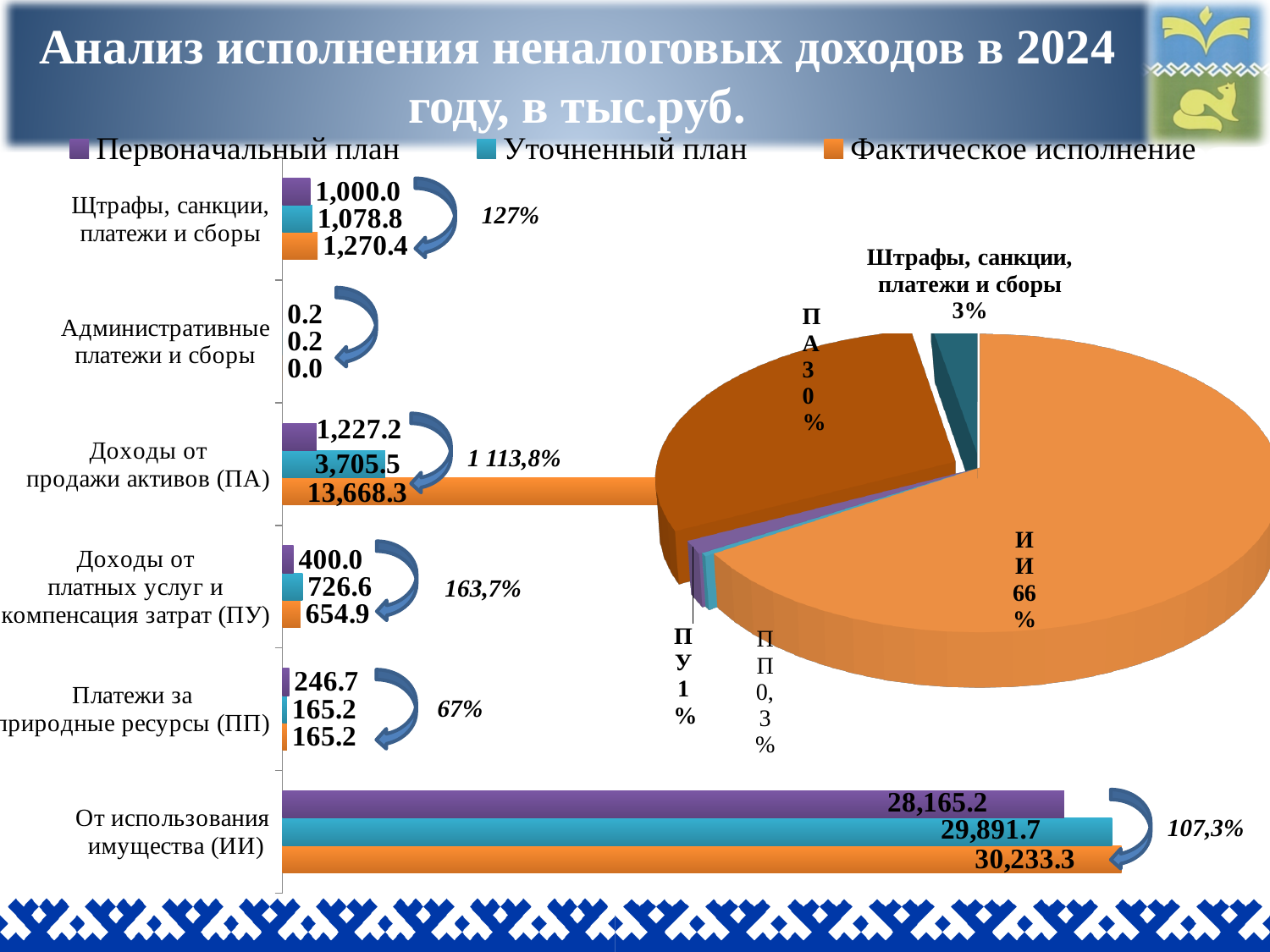
What type of chart is the chart on the left side of the slide? bar chart On the bar chart, which category has the highest Фактическое исполнение value? От использования имущества (ИИ) On the bar chart, what is the value of Фактическое исполнение for Доходы от продажи активов (ПА)? 13,668.3 On the bar chart, which is larger for Доходы от платных услуг и компенсация затрат (ПУ): Уточненный план or Фактическое исполнение? Уточненный план On the bar chart, what is the difference between Фактическое исполнение and Первоначальный план for От использования имущества (ИИ)? 2,068.1 On the bar chart, which category has the lowest Фактическое исполнение value? Административные платежи и сборы On the pie chart, what share does Штрафы, санкции, платежи и сборы have? 3% On the bar chart, what is the value of Уточненный план for Штрафы, санкции, платежи и сборы? 1,078.8 How many series does the bar chart legend list? 3 On the bar chart, what is the value of Первоначальный план for От использования имущества (ИИ)? 28,165.2 On the pie chart, what share does ИИ have? 66% How many categories does the bar chart show? 6